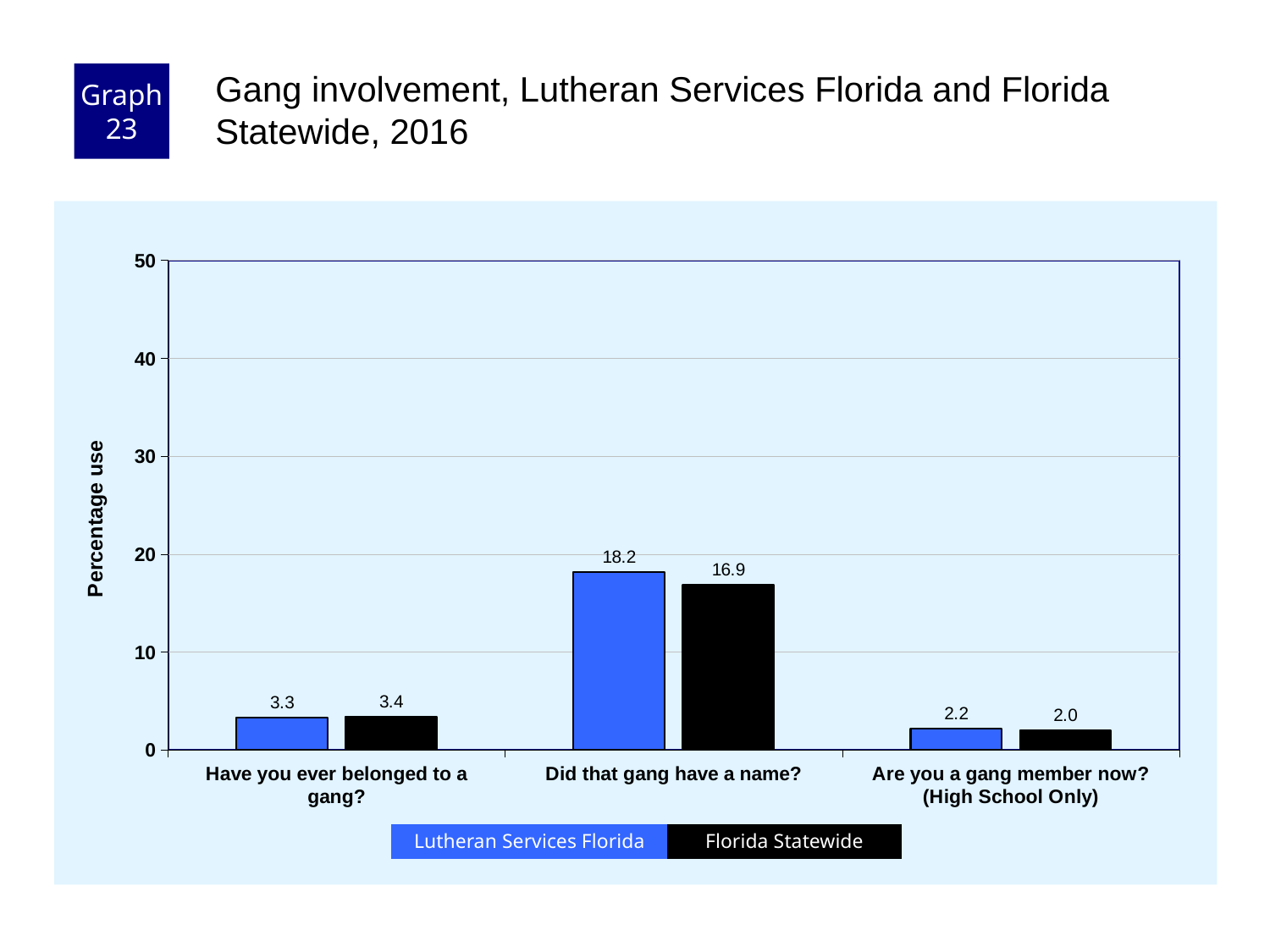
What is the Florida Statewide value for "Are you a gang member now? (High School Only)"? 2.0 How many series does the legend list? 2 What kind of chart is shown on the slide? bar chart What is the Lutheran Services Florida value for "Did that gang have a name?"? 18.2 What is the Florida Statewide value for "Have you ever belonged to a gang?"? 3.4 For "Did that gang have a name?", which is larger: Lutheran Services Florida or Florida Statewide? Lutheran Services Florida Which question has the lowest Florida Statewide value? Are you a gang member now? (High School Only) What is the label on the y axis? Percentage use How many questions (categories) are shown on the x axis? 3 Is the Lutheran Services Florida value for "Did that gang have a name?" greater or less than 20? less What is the difference between the Lutheran Services Florida and Florida Statewide values for "Did that gang have a name?"? 1.3 Which question has the highest Lutheran Services Florida value? Did that gang have a name?